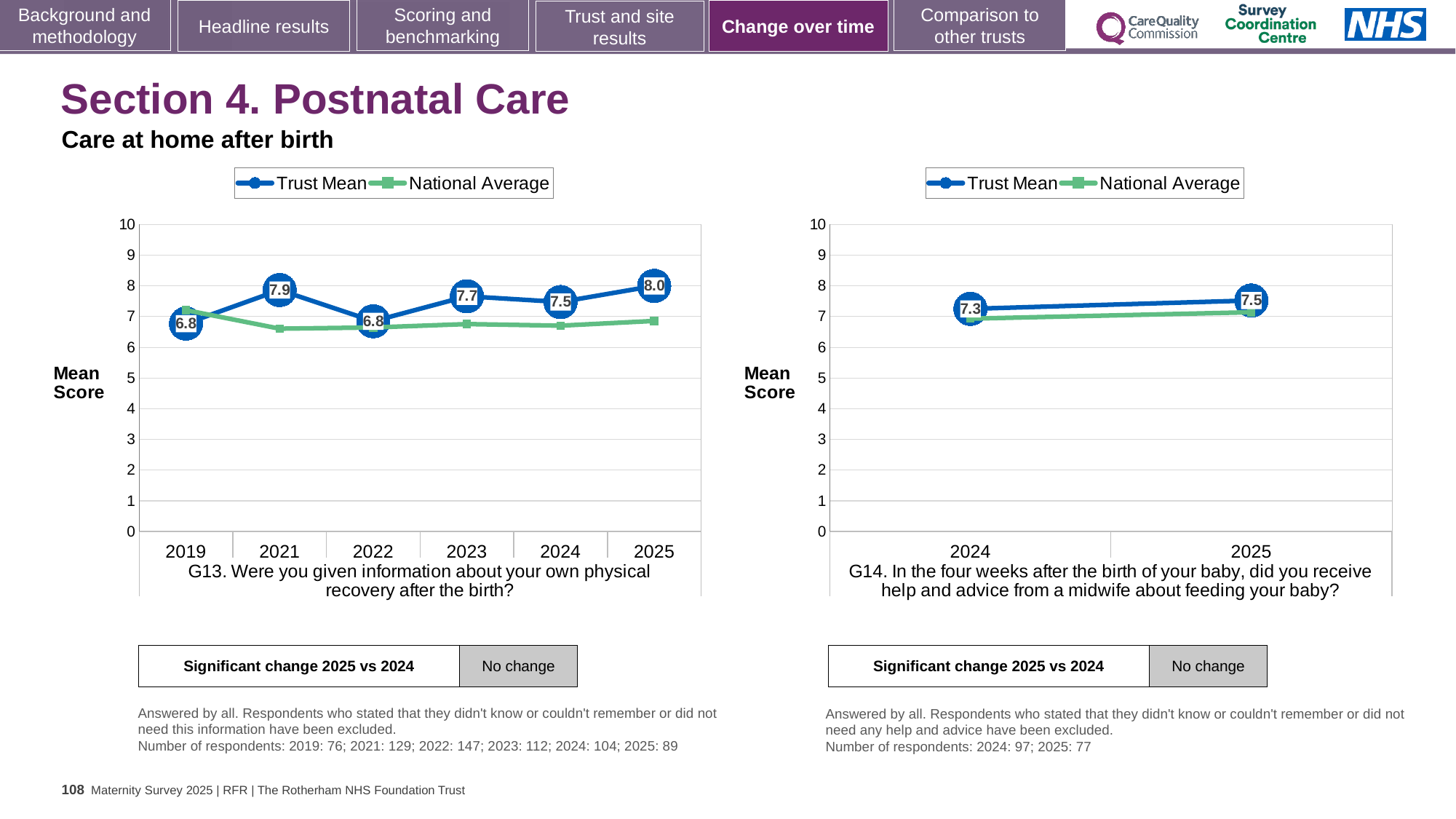
In the G13 chart on the left, what is the Trust Mean for 2025? 8.0 In the G13 chart on the left, is the Trust Mean higher in 2021 or in 2022? 2021 In the G14 chart on the right, does the Trust Mean rise or fall from 2024 to 2025? Rise In the G14 chart on the right, is the National Average for 2025 greater or less than 6? greater In the G13 chart on the left, what is the Trust Mean for 2019? 6.8 What type of chart is the G13 chart on the left? Line chart In the G13 chart on the left, which year has the highest Trust Mean? 2025 How many years are shown on the x axis of the G13 chart on the left? 6 In the G13 chart on the left, what is the difference between the Trust Mean in 2025 and in 2024? 0.5 In the G14 chart on the right, what is the difference between the Trust Mean in 2025 and in 2024? 0.2 In the G14 chart on the right, what is the Trust Mean for 2024? 7.3 How many series does the legend of the G14 chart on the right list? 2